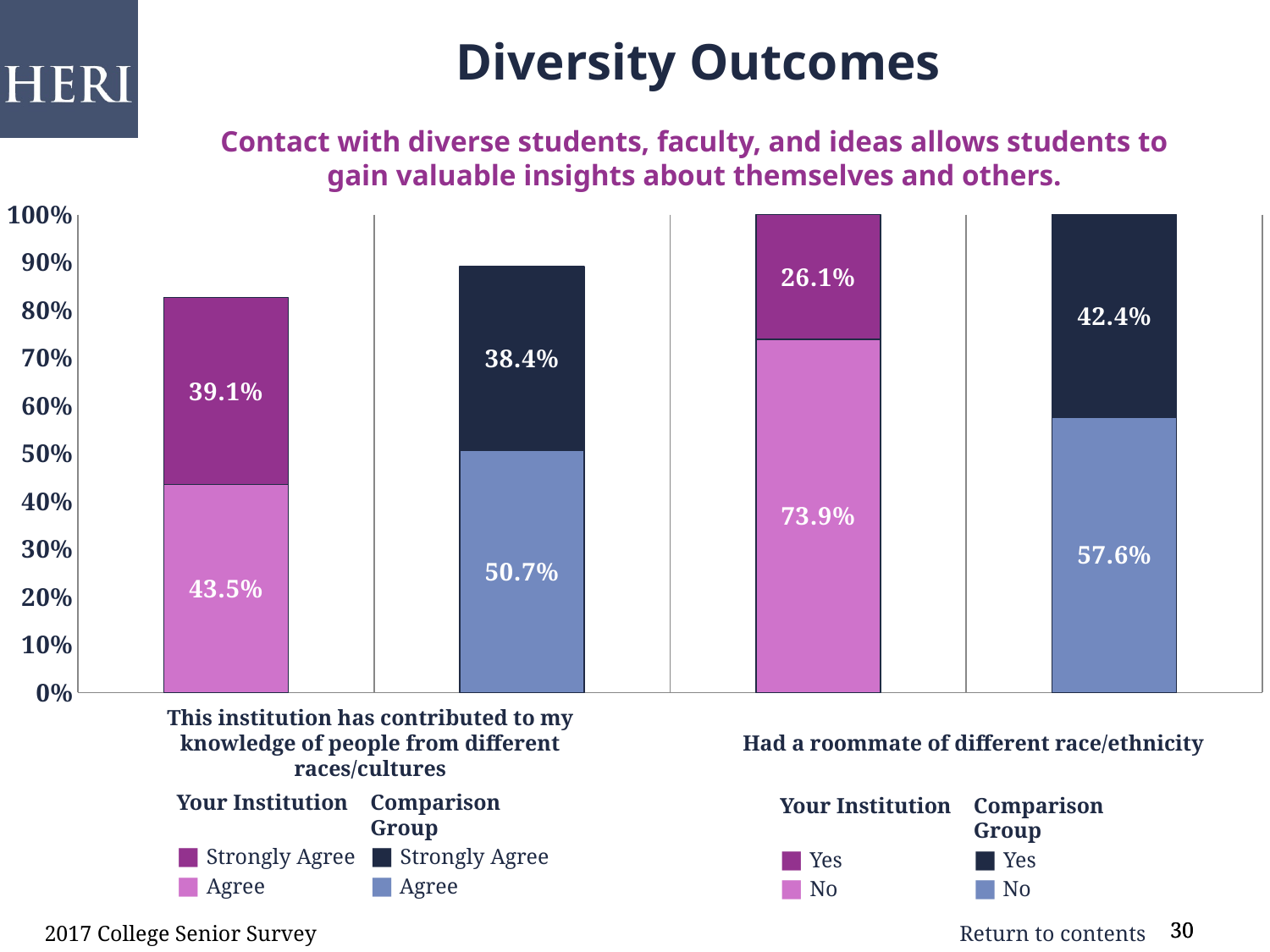
What percentage of Your Institution students strongly agree that the institution has contributed to their knowledge of people from different races/cultures? 39.1% What percentage of Your Institution students answered Yes to having had a roommate of a different race/ethnicity? 26.1% Which group has a higher percentage answering No to having had a roommate of a different race/ethnicity, Your Institution or the Comparison Group? Your Institution What kind of chart is shown on the slide? Stacked bar chart How many bars are plotted in the chart? 4 What is the difference between the Comparison Group and Your Institution in the percentage answering Yes to having had a roommate of a different race/ethnicity? 16.3% What is the combined percentage of the Comparison Group who agree or strongly agree that the institution has contributed to their knowledge of people from different races/cultures? 89.1% What percentage of the Comparison Group agree (not strongly) that the institution has contributed to their knowledge of people from different races/cultures? 50.7% What is the title of the slide containing the chart? Diversity Outcomes What is the combined percentage of Your Institution students who agree or strongly agree that the institution has contributed to their knowledge of people from different races/cultures? 82.6% Is the percentage of Your Institution students who strongly agree that the institution contributed to their knowledge of people from different races/cultures greater or less than 30%? greater What percentage of the Comparison Group answered No to having had a roommate of a different race/ethnicity? 57.6%